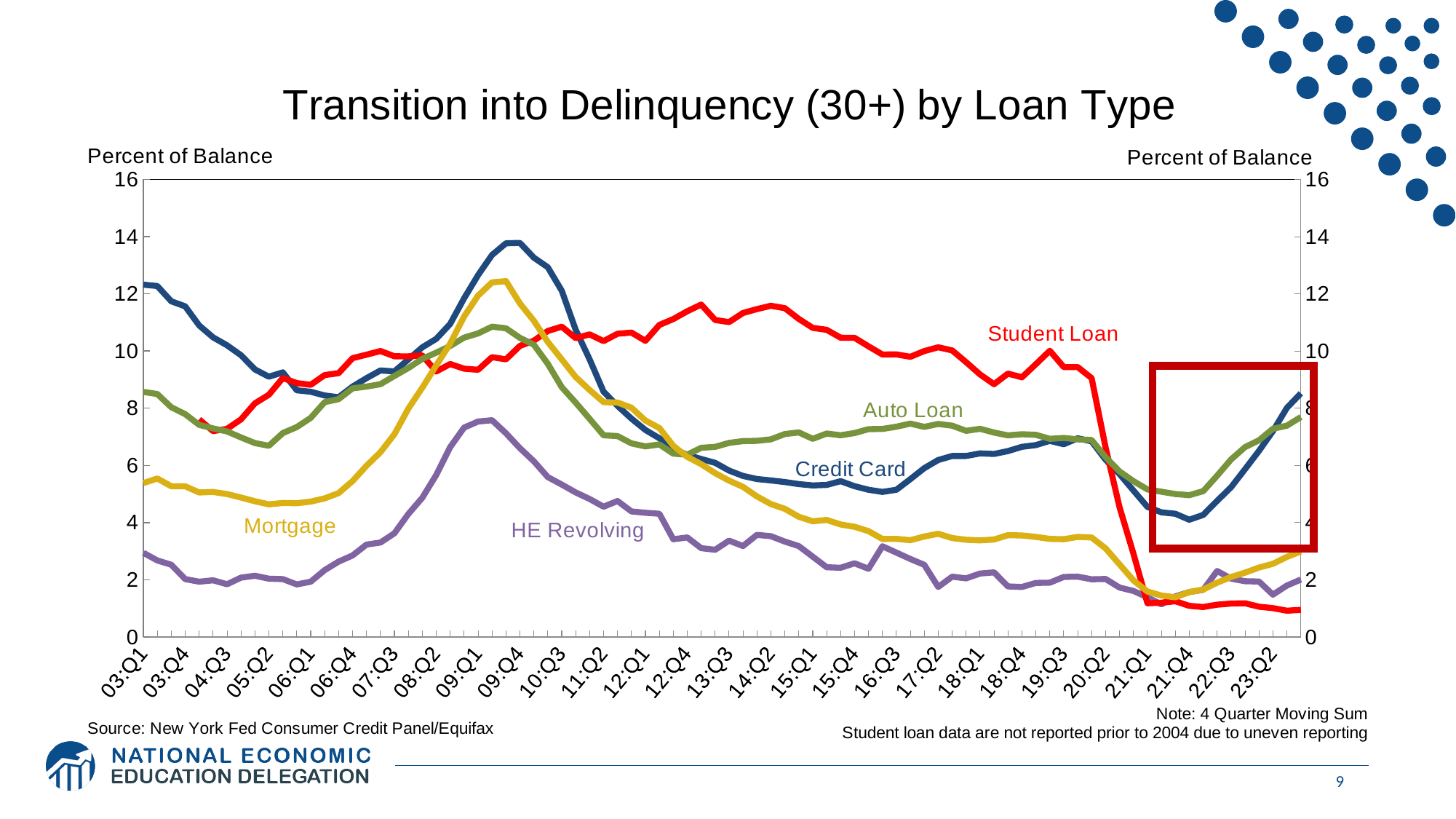
At 09:Q4, which is larger: Credit Card or HE Revolving? Credit Card Is the value for Student Loan around 14:Q2 greater or less than 10? greater What is the label on the vertical axis of the chart? Percent of Balance What kind of chart is shown on the slide? Line chart Which series has the lowest value at 23:Q2? Student Loan Is the value for Student Loan at 23:Q2 greater or less than 2? less Is the value for Credit Card at its peak around 09:Q4 greater or less than 12? greater Which series has the highest value around 14:Q2? Student Loan What is the title of the chart? Transition into Delinquency (30+) by Loan Type Does the Student Loan series rise or fall between 19:Q3 and 21:Q1? Fall How many loan-type series are plotted on the chart? 5